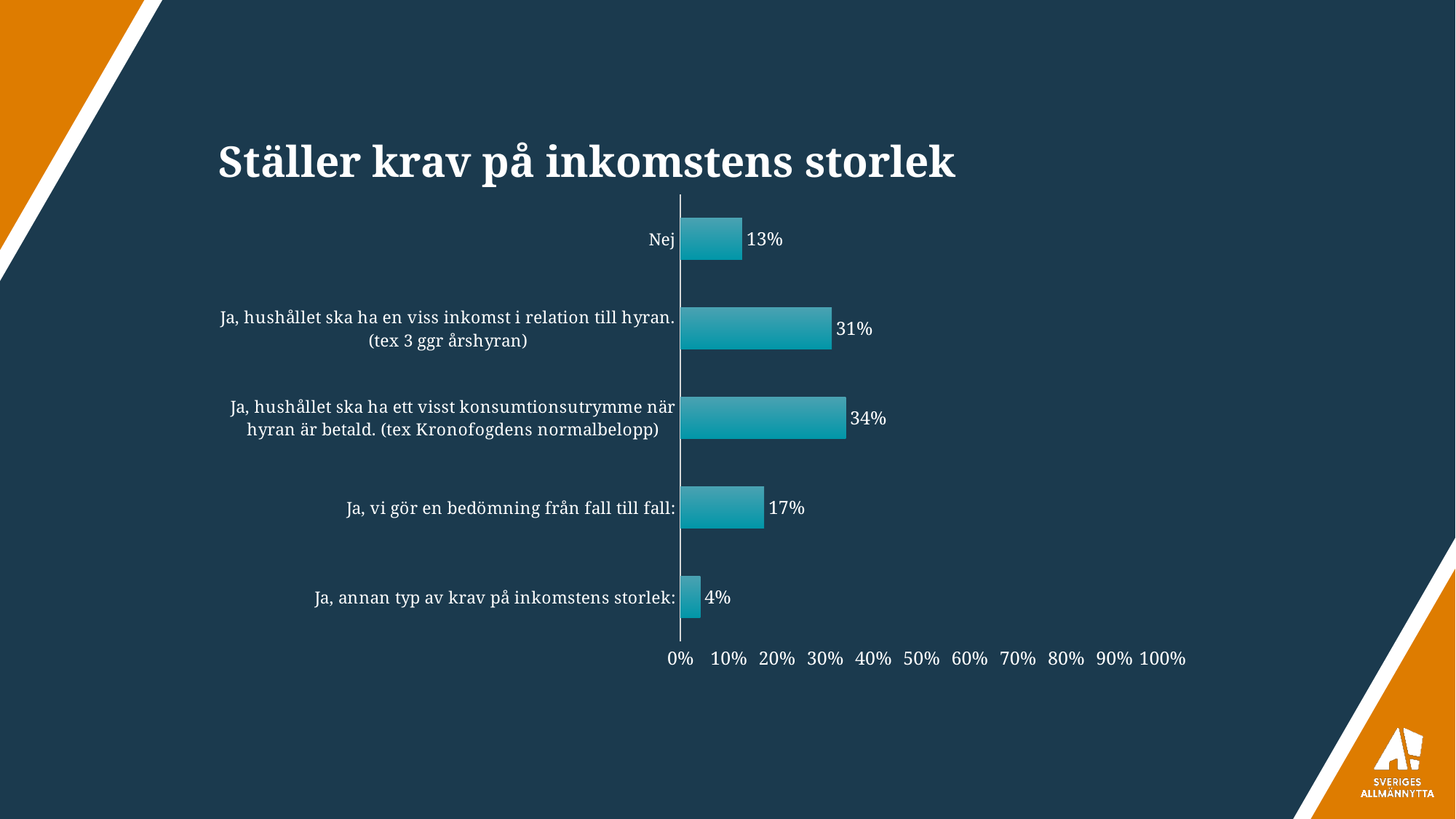
Which is larger: the value for "Nej" or the value for "Ja, vi gör en bedömning från fall till fall:"? Ja, vi gör en bedömning från fall till fall: What is the difference between the value for "Ja, hushållet ska ha ett visst konsumtionsutrymme när hyran är betald. (tex Kronofogdens normalbelopp)" and the value for "Ja, hushållet ska ha en viss inkomst i relation till hyran. (tex 3 ggr årshyran)"? 3% Which category has the highest value? Ja, hushållet ska ha ett visst konsumtionsutrymme när hyran är betald. (tex Kronofogdens normalbelopp) Which category has the lowest value? Ja, annan typ av krav på inkomstens storlek: Is the value for "Ja, hushållet ska ha en viss inkomst i relation till hyran. (tex 3 ggr årshyran)" greater or less than 20%? greater What kind of chart is shown on the slide? bar chart What is the value for "Ja, annan typ av krav på inkomstens storlek:"? 4% What is the value for "Ja, vi gör en bedömning från fall till fall:"? 17% What is the value for "Ja, hushållet ska ha en viss inkomst i relation till hyran. (tex 3 ggr årshyran)"? 31% What is the title of the chart? Ställer krav på inkomstens storlek What is the value for "Nej"? 13% How many categories are shown in the chart? 5